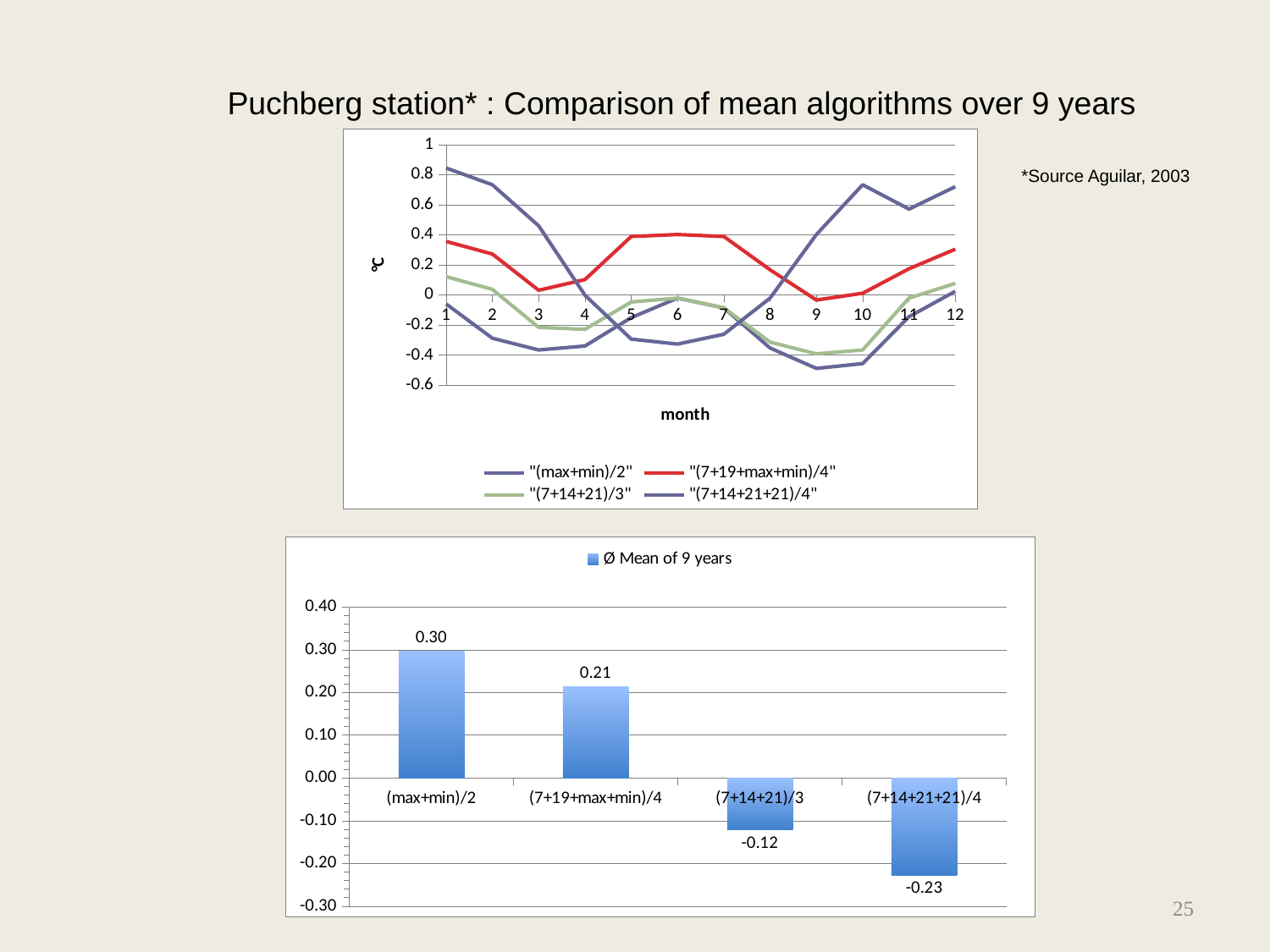
In the bottom bar chart, what is the value for (7+19+max+min)/4? 0.21 In the bottom bar chart, which category has the lowest value? (7+14+21+21)/4 In the bottom bar chart, what is the value for (max+min)/2? 0.30 In the top line chart, is the value of the red "(7+19+max+min)/4" series at month 5 greater or less than 0.2? greater How many series does the legend of the top line chart list? 4 What kind of chart is the top chart on the slide? Line chart What kind of chart is the bottom chart on the slide? Bar chart In the bottom bar chart, which category has the highest value? (max+min)/2 In the bottom bar chart, what is the difference between the values for (max+min)/2 and (7+19+max+min)/4? 0.09 In the bottom bar chart, which is larger: the value for (7+14+21)/3 or the value for (7+14+21+21)/4? (7+14+21)/3 How many bars are shown in the bottom bar chart? 4 In the bottom bar chart, what is the value for (7+14+21+21)/4? -0.23